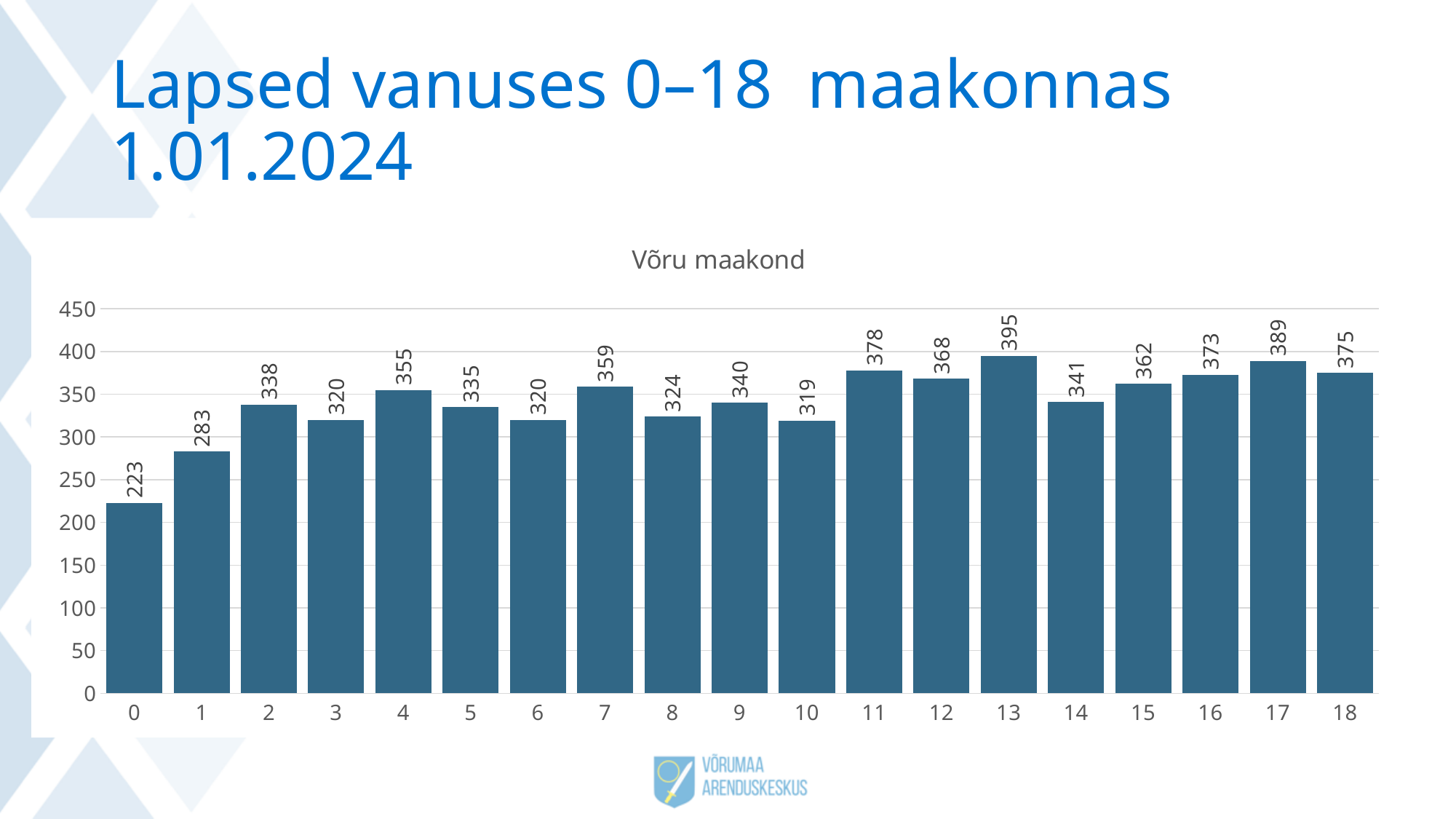
Which age has the highest value? 13 What is the value for age 7? 359 Which age has the lowest value? 0 What is the value for age 13? 395 Which is larger, the value for age 4 or the value for age 9? age 4 What is the value for age 0? 223 What is the difference between the values for age 17 and age 14? 48 What kind of chart is shown on the slide? bar chart Is the value for age 1 greater or less than 300? less What is the difference between the values for age 13 and age 0? 172 How many age categories are shown on the x axis? 19 What is the title of the chart? Võru maakond